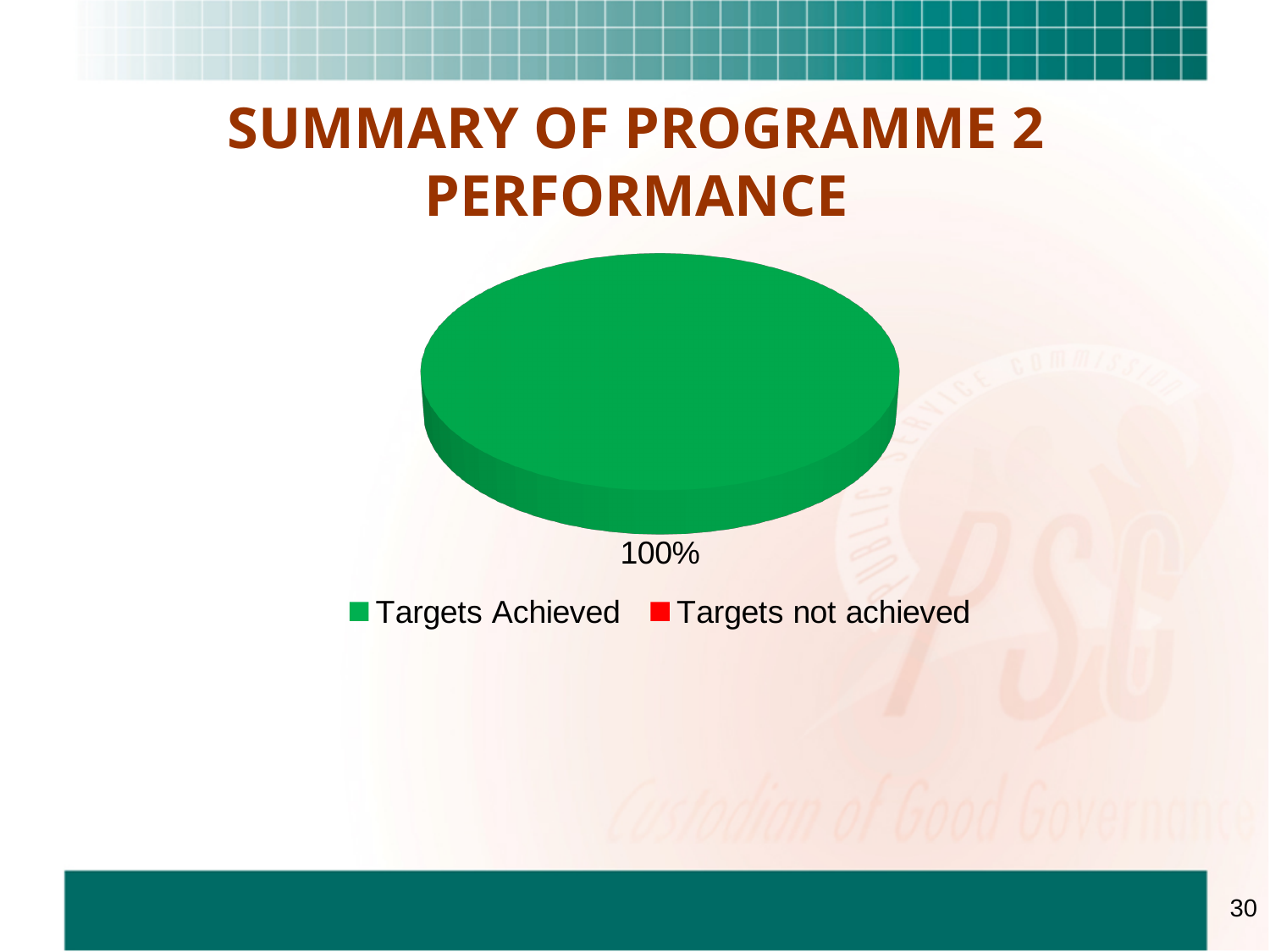
What colour represents Targets not achieved in the legend? red What is the value shown for Targets Achieved? 100% Is the value for Targets Achieved greater or less than 50%? greater What kind of chart is shown on the slide? pie chart What colour represents Targets Achieved in the legend? green Which is larger, Targets Achieved or Targets not achieved? Targets Achieved What share of the pie does Targets Achieved represent? 100% How many entries does the legend list? 2 Which category has the largest share of the pie? Targets Achieved